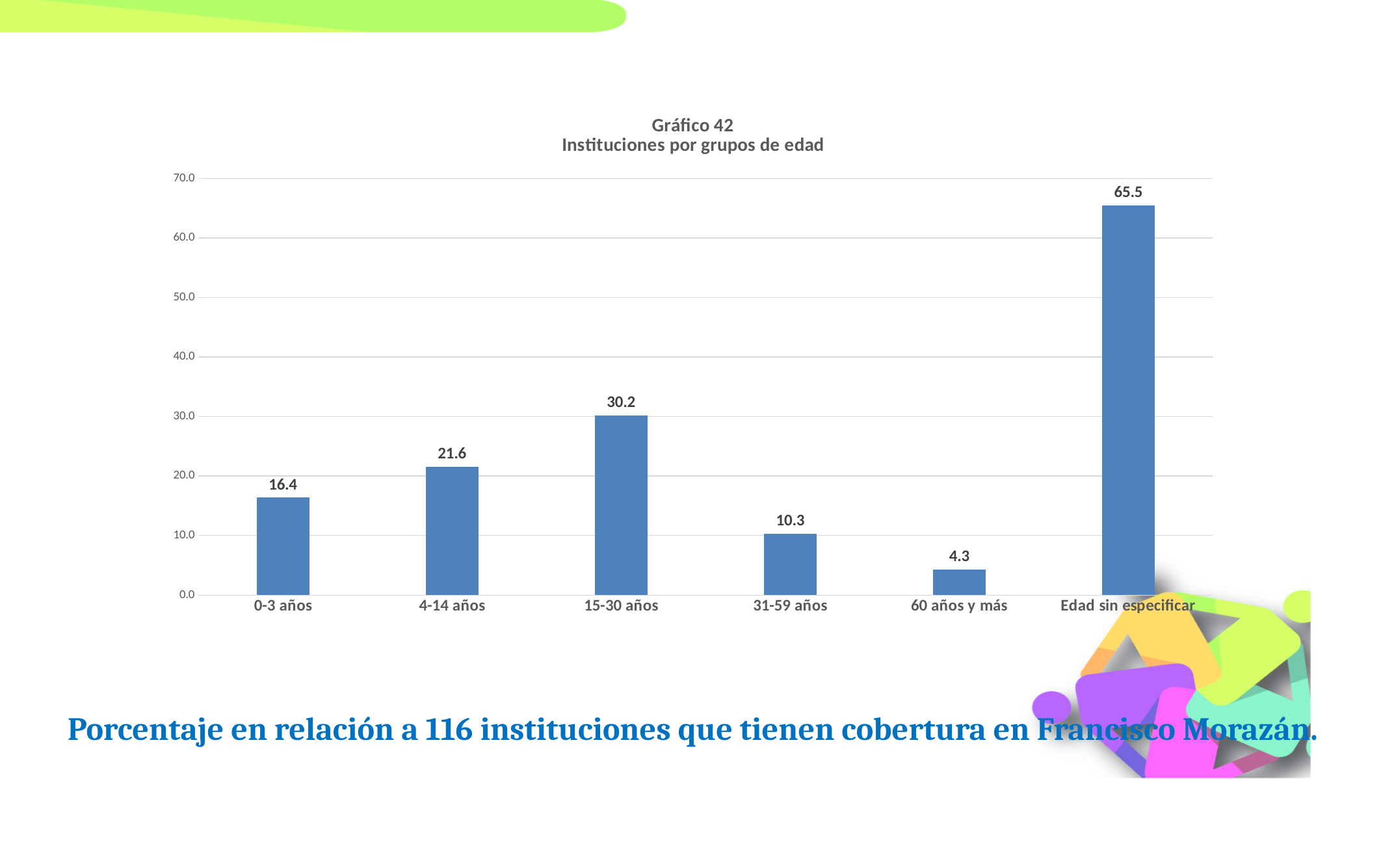
What kind of chart is shown on the slide? bar chart Which category has the highest value? Edad sin especificar Which is larger, the value for 0-3 años or the value for 4-14 años? 4-14 años What is the difference between the values for 4-14 años and 31-59 años? 11.3 What is the difference between the values for Edad sin especificar and 15-30 años? 35.3 What is the title of the chart? Gráfico 42 Instituciones por grupos de edad What is the value for the 15-30 años category? 30.2 Is the value for 31-59 años greater or less than 20.0? less How many categories are shown on the x axis? 6 Which category has the lowest value? 60 años y más What is the value for the 60 años y más category? 4.3 What is the value for the 0-3 años category? 16.4